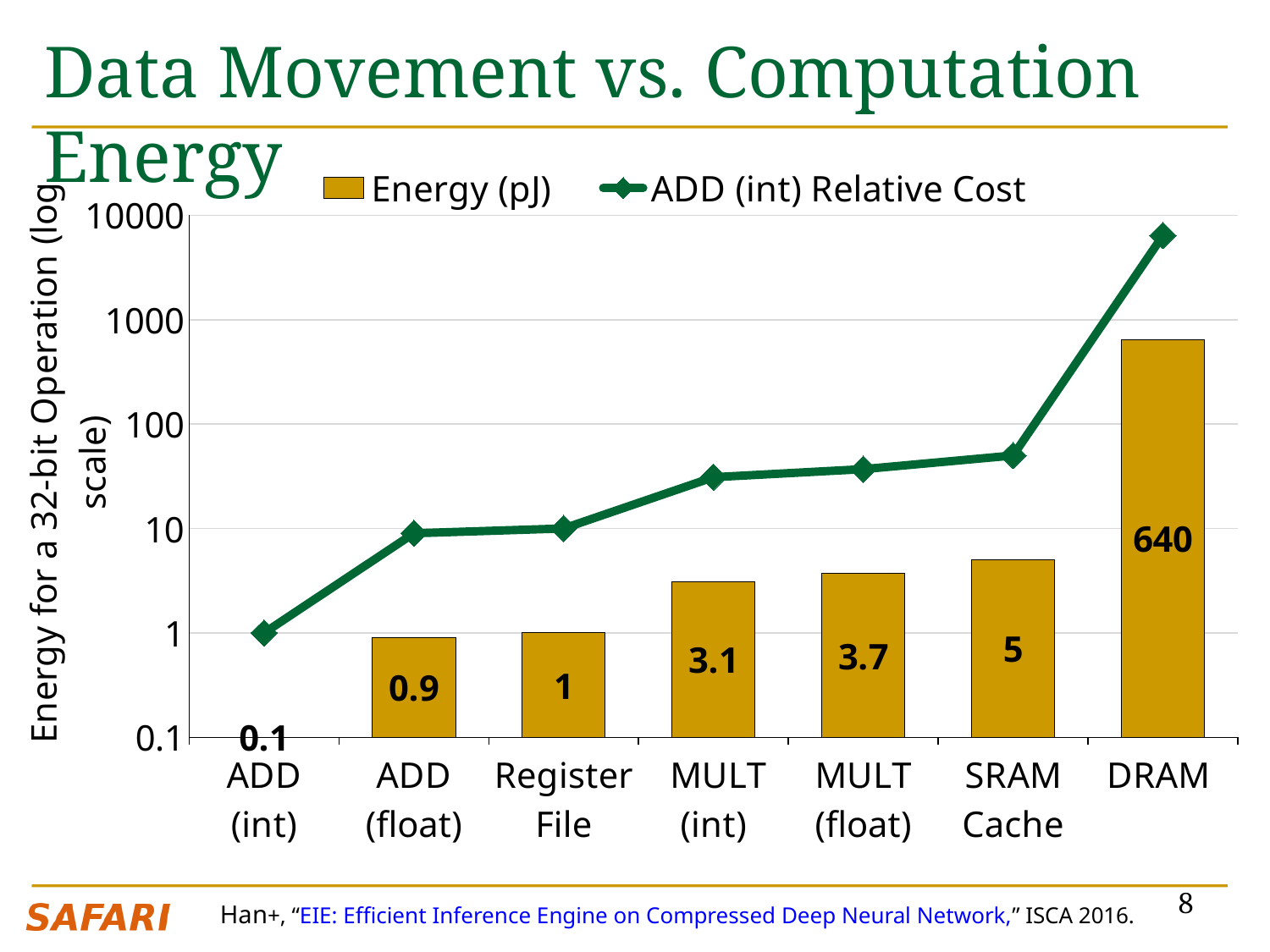
What is the Energy (pJ) value for SRAM Cache? 5 How many categories are shown on the x axis? 7 Which category has the highest Energy (pJ)? DRAM What is the Energy (pJ) value for MULT (float)? 3.7 What is the Energy (pJ) value for DRAM? 640 Which has a higher Energy (pJ), Register File or ADD (float)? Register File Is the ADD (int) Relative Cost for DRAM greater or less than 1000? greater What is the difference in Energy (pJ) between MULT (float) and MULT (int)? 0.6 How many series does the legend list? 2 Which category has the lowest Energy (pJ)? ADD (int) What is the Energy (pJ) value for ADD (int)? 0.1 Does the ADD (int) Relative Cost line rise or fall from ADD (int) to DRAM? rise